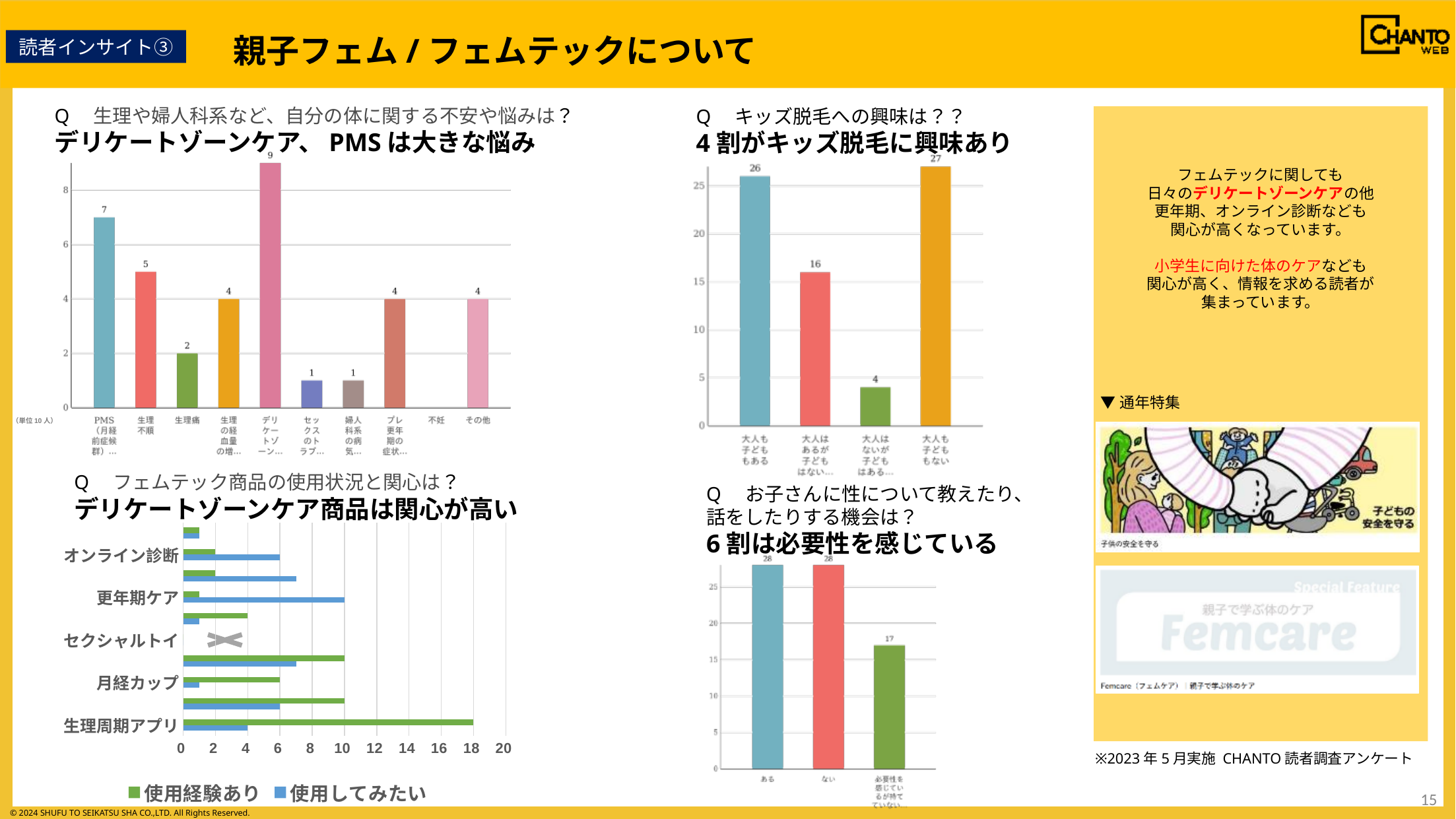
In the chart for 「キッズ脱毛への興味は？？」, what is the value for 大人はあるが子どもはない? 16 In the chart for 「お子さんに性について教えたり、話をしたりする機会は？」, how many bars are shown? 3 In the chart for 「キッズ脱毛への興味は？？」, which is larger, the value for 大人も子どももある or 大人はあるが子どもはない? 大人も子どももある In the chart for 「フェムテック商品の使用状況と関心は？」, how many series does the legend list? 2 In the chart for 「キッズ脱毛への興味は？？」, which category has the lowest value? 大人はないが子どもはある In the chart for 「お子さんに性について教えたり、話をしたりする機会は？」, what is the value for ない? 28 In the chart for 「生理や婦人科系など、自分の体に関する不安や悩みは？」, what is the value for PMS? 7 In the chart for 「キッズ脱毛への興味は？？」, what is the difference between the values for 大人も子どももない and 大人はないが子どもはある? 23 In the chart for 「生理や婦人科系など、自分の体に関する不安や悩みは？」, what is the difference between the values for PMS and 生理不順? 2 In the chart for 「生理や婦人科系など、自分の体に関する不安や悩みは？」, how many categories are shown on the x axis? 10 In the chart for 「生理や婦人科系など、自分の体に関する不安や悩みは？」, which category has the highest value? デリケートゾーン What kind of chart is used for 「フェムテック商品の使用状況と関心は？」? Bar chart